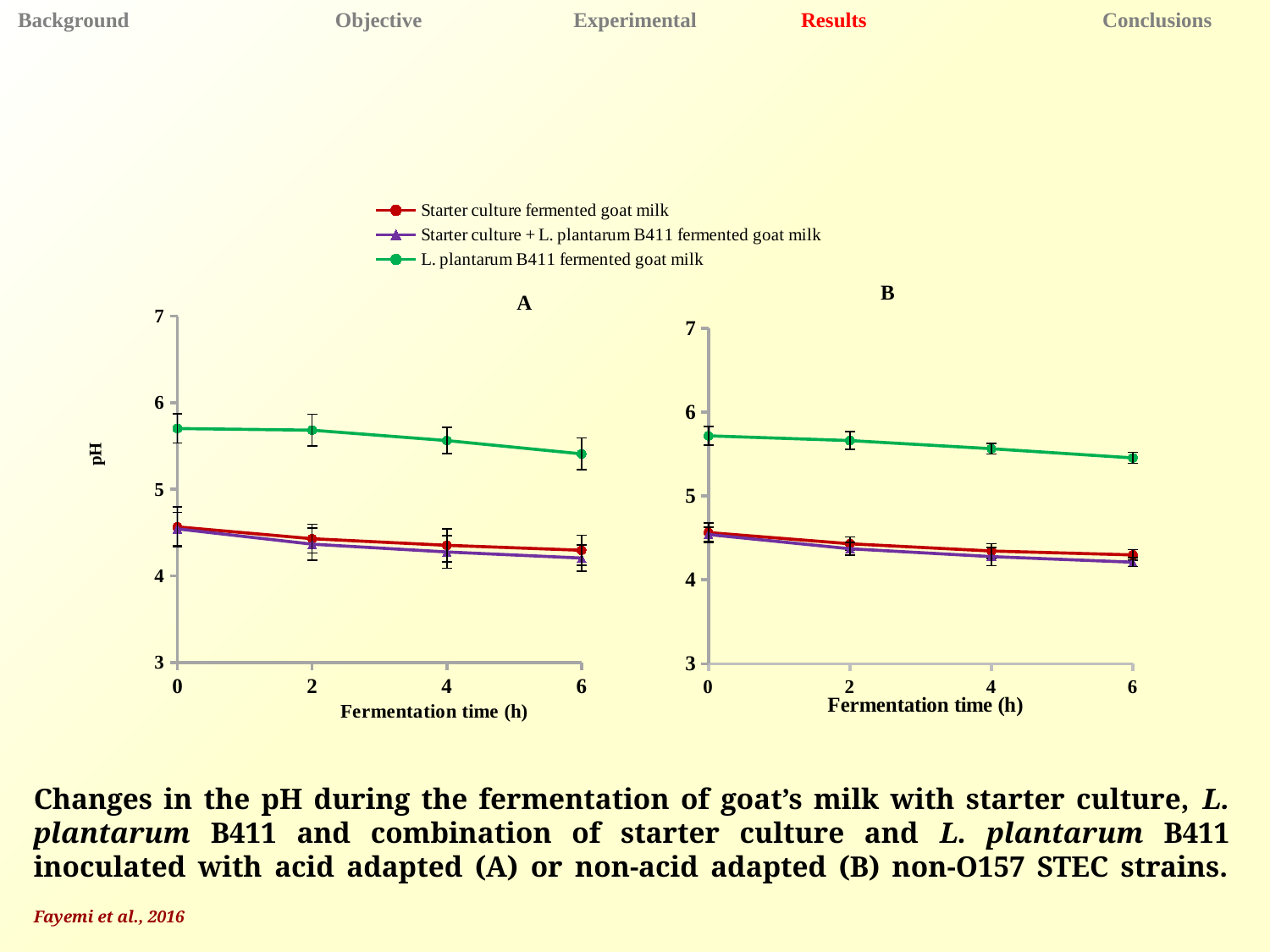
In chart B, is the pH of the L. plantarum B411 fermented goat milk at 6 h greater or less than 6? less In chart A, is the pH of the L. plantarum B411 fermented goat milk at 0 h greater or less than 5? greater What is the label of the x axis in chart A? Fermentation time (h) What kind of chart is chart A? line chart How many series does the legend list? 3 In chart B, does the pH of the L. plantarum B411 fermented goat milk rise or fall as fermentation time increases? fall In chart B, is the pH of the starter culture + L. plantarum B411 fermented goat milk at 6 h greater or less than 5? less Which colour is used for the starter culture fermented goat milk series? red In chart A, which has the higher pH at 4 h: the L. plantarum B411 fermented goat milk or the starter culture fermented goat milk? L. plantarum B411 fermented goat milk In chart B, which series has the highest pH at 6 h? L. plantarum B411 fermented goat milk In chart A, how many fermentation time points are plotted for each series? 4